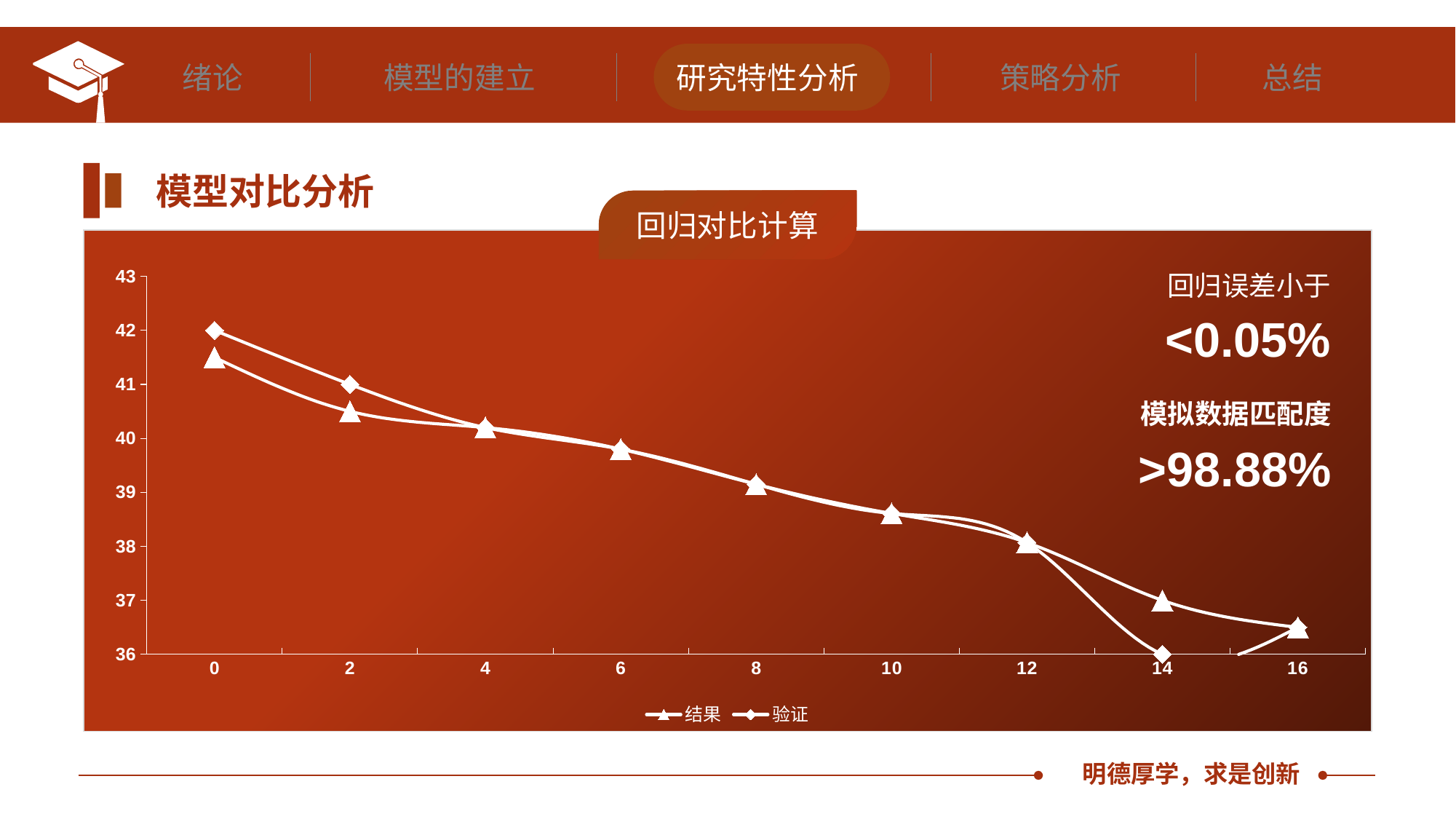
What is the value of the 验证 series at x = 14? 36 What is the value of the 验证 series at x = 2? 41 At x = 0, which series has the larger value, 结果 or 验证? 验证 Do the values of the 结果 series rise or fall as x increases from 0 to 16? fall At x = 14, which series has the larger value, 结果 or 验证? 结果 What are the two series named in the chart legend? 结果 and 验证 What is the value of the 结果 series at x = 14? 37 What is the title shown above the chart? 回归对比计算 Is the value of the 结果 series at x = 8 greater or less than 40? less What kind of chart is shown on the slide? line chart How many series does the chart legend list? 2 What is the value of the 验证 series at x = 0? 42